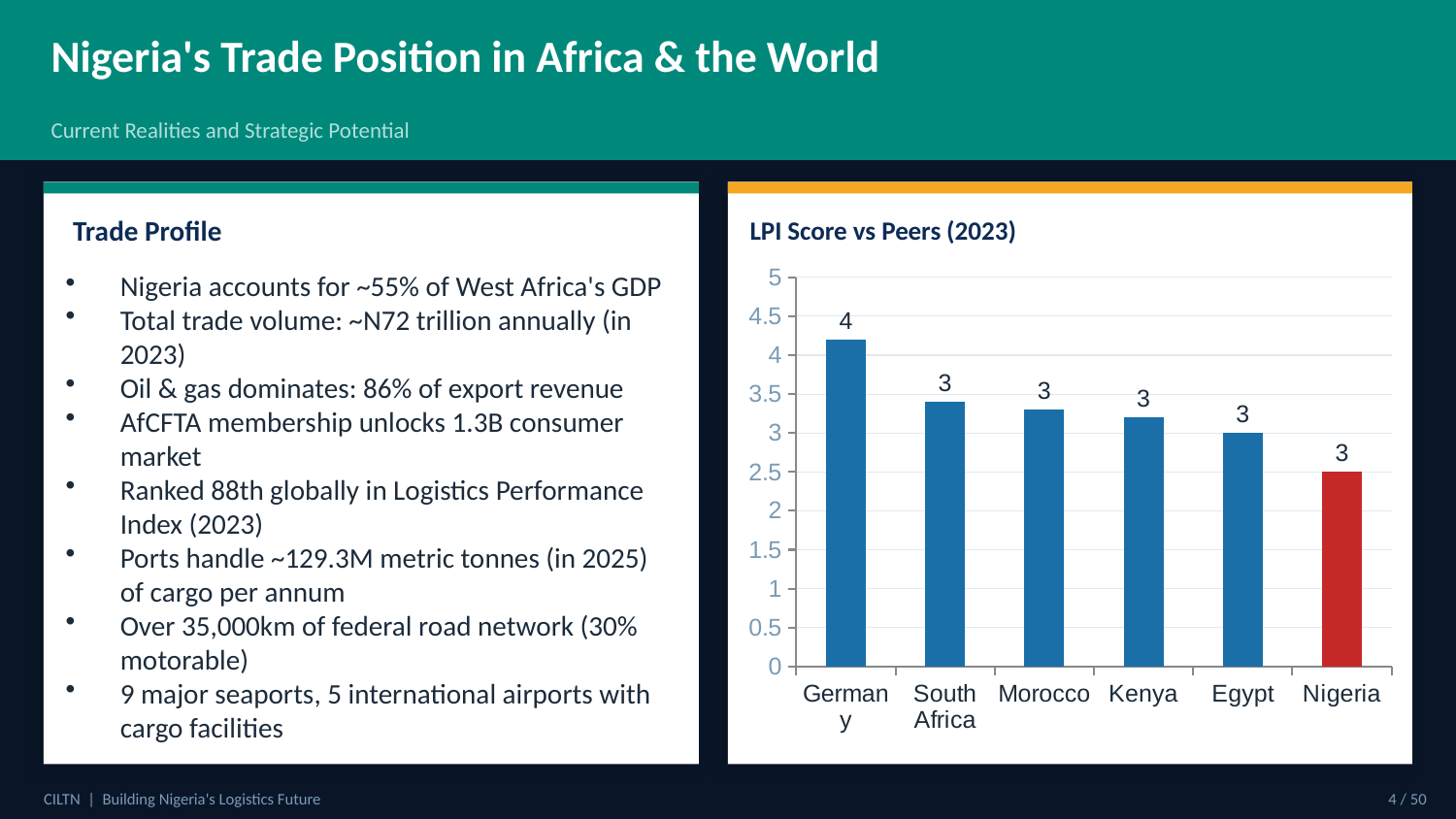
Do the LPI scores rise or fall moving from left to right across the chart? fall Is the value for Nigeria greater or less than 3? less Is the value for South Africa greater or less than 3? greater Which country has the lowest LPI score in the chart? Nigeria How many countries are shown in the chart? 6 Which country's bar is coloured red rather than blue? Nigeria Which country has the highest LPI score in the chart? Germany What kind of chart is shown on the slide? bar chart Is the value for Germany greater or less than 4? greater What is the title of the chart? LPI Score vs Peers (2023) Which has a higher LPI score, Germany or Nigeria? Germany What is the data label shown for Egypt? 3